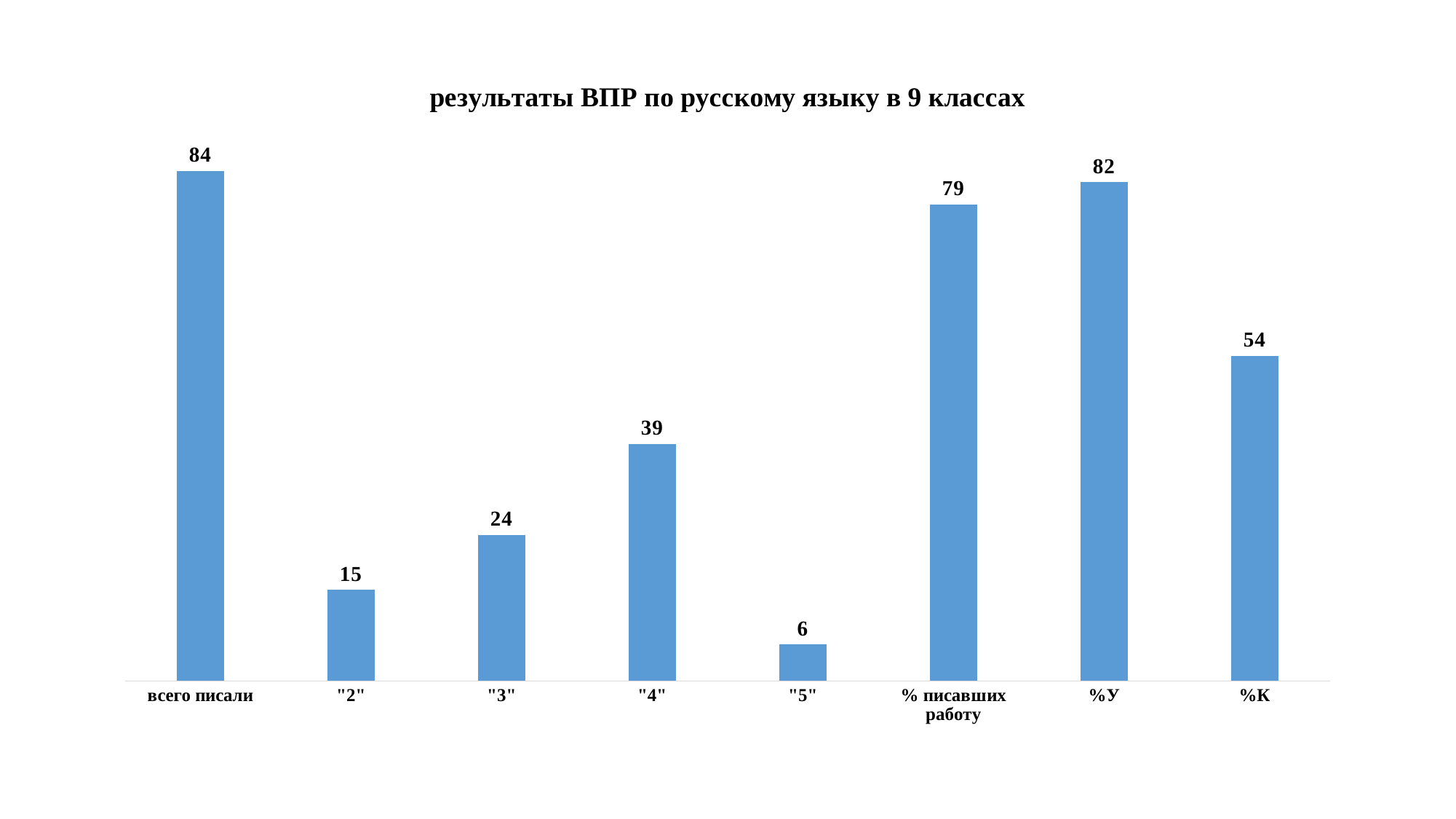
Which category has the lowest value? "5" What is the value for "4"? 39 What kind of chart is shown on the slide? bar chart What is the difference between the values for "%У" and "%К"? 28 What is the value for "всего писали"? 84 Which is larger, the value for "3" or the value for "2"? "3" What is the difference between the values for "4" and "2"? 24 Which category has the highest value? всего писали What is the value for "% писавших работу"? 79 What is the title of the chart? результаты ВПР по русскому языку в 9 классах How many categories are shown on the x axis? 8 What is the value for "%У"? 82